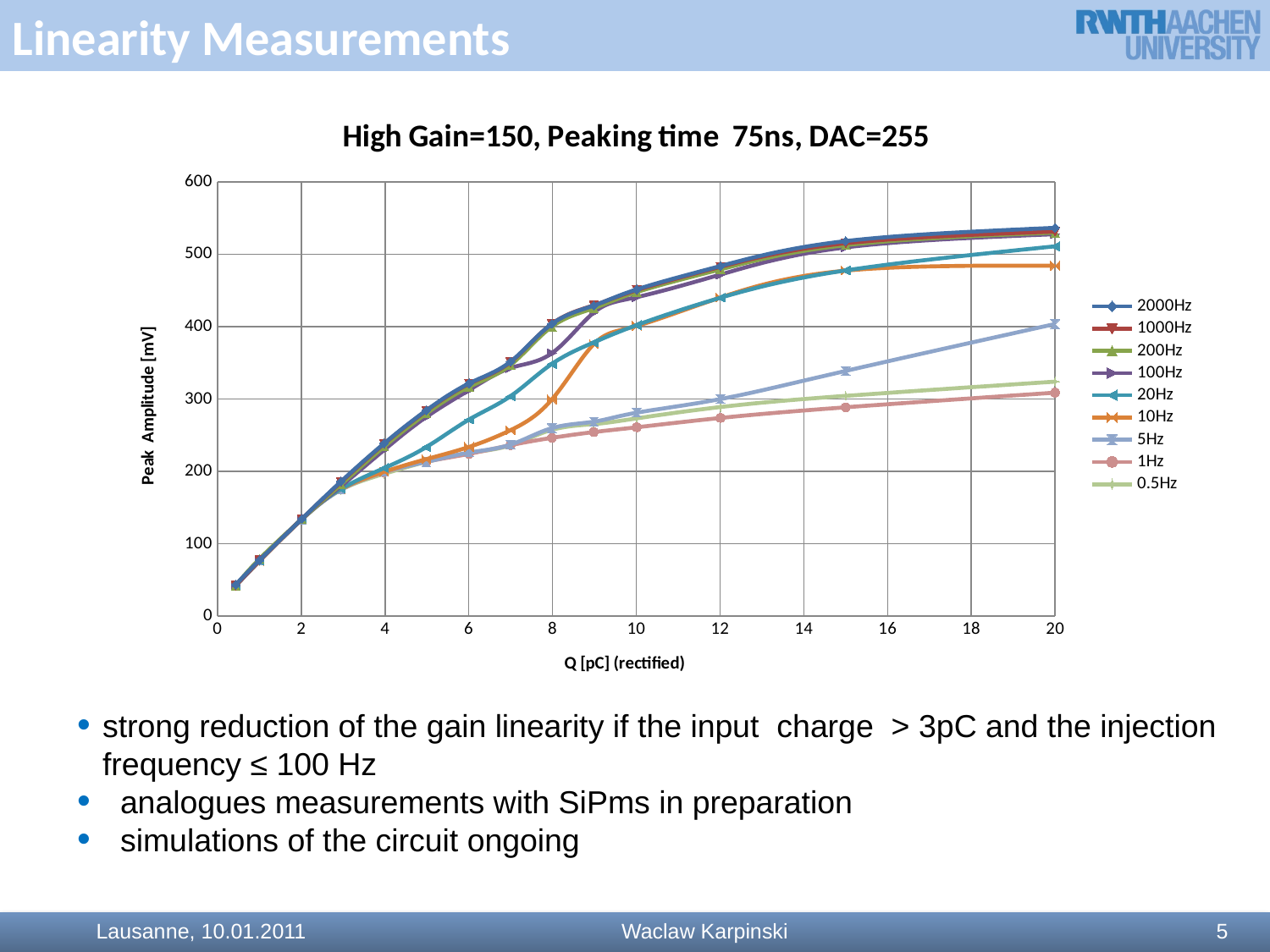
Is the value of the 20Hz series at Q = 10 pC greater or less than 300? greater Is the value of the 2000Hz series at Q = 20 pC greater or less than 500? greater How many series does the legend list? 9 What kind of chart is shown on the slide? line chart At Q = 20 pC, which series has the larger value, 5Hz or 1Hz? 5Hz Is the value of the 5Hz series at Q = 20 pC greater or less than 300? greater What is the title of the chart? High Gain=150, Peaking time 75ns, DAC=255 Do the values of the 2000Hz series rise or fall as Q increases along the x axis? rise What is the label of the y axis? Peak Amplitude [mV] At Q = 10 pC, which series has the larger value, 2000Hz or 1Hz? 2000Hz